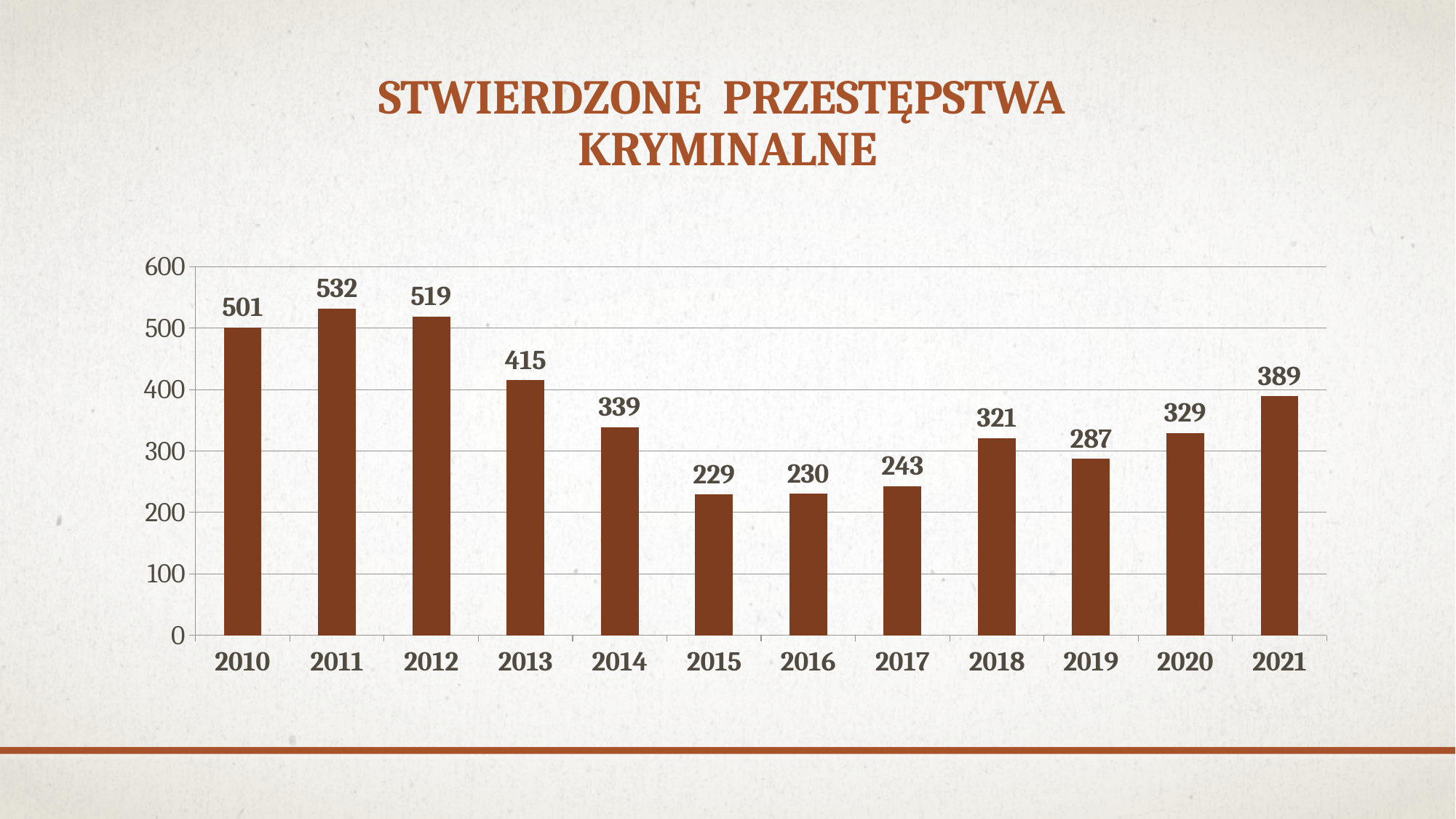
Is the value for 2012 greater or less than 500? greater What is the value for 2019? 287 How many years are shown on the x axis? 12 Which is larger, the value for 2018 or the value for 2020? 2020 Which year has the lowest value? 2015 What is the title of the chart? STWIERDZONE PRZESTĘPSTWA KRYMINALNE What is the difference between the values for 2014 and 2015? 110 Do the values rise or fall from 2012 to 2015? fall What kind of chart is shown on the slide? bar chart Which year has the highest value? 2011 What is the difference between the values for 2011 and 2021? 143 What is the value for 2013? 415